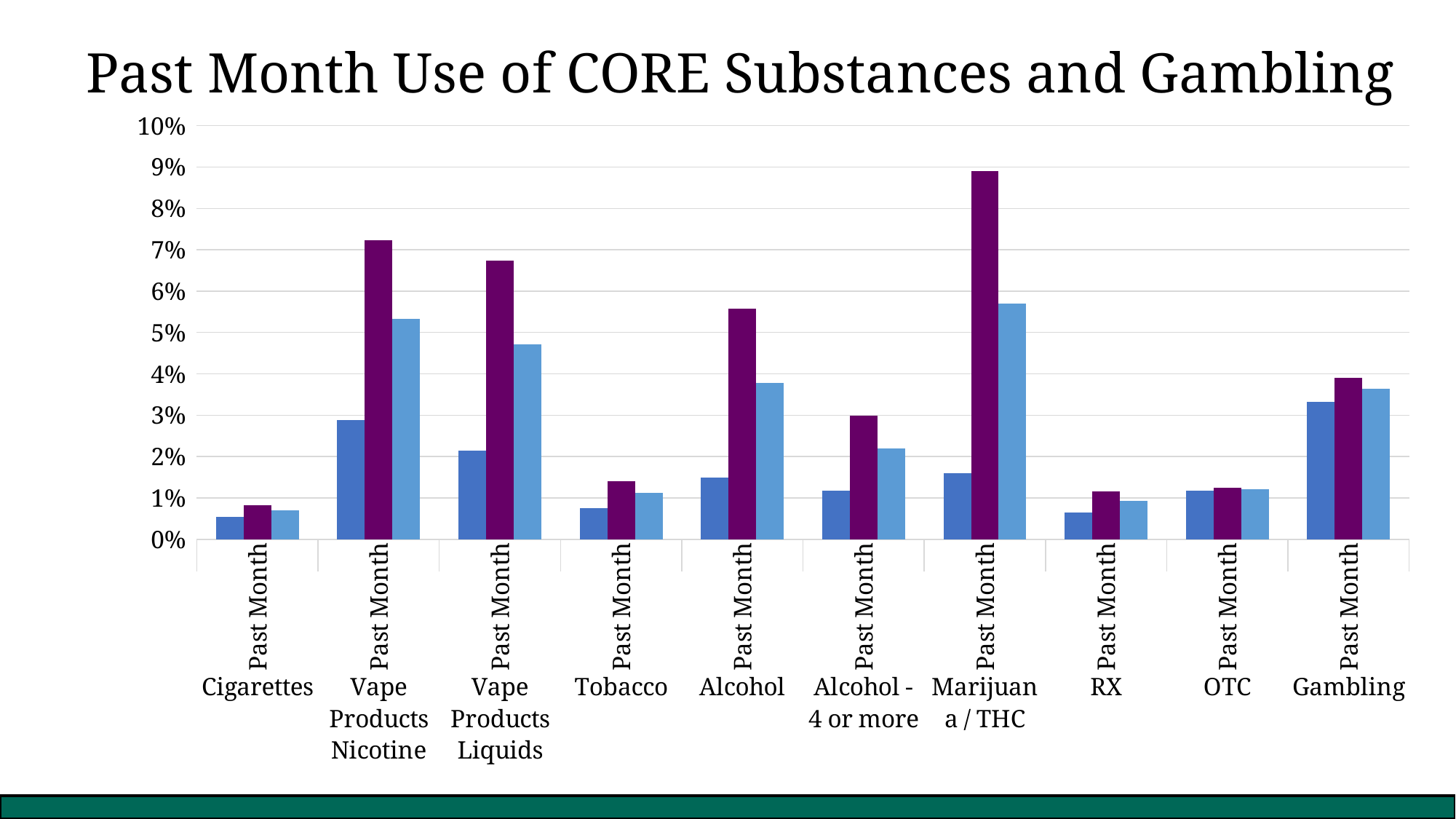
Is the purple bar for Alcohol greater or less than 5%? greater Which category has the shortest bars on the chart? Cigarettes How many substance/gambling categories are shown along the x axis? 10 What kind of chart is shown on the slide? bar chart Which category has the tallest bar on the chart? Marijuana / THC Is the dark blue bar for Cigarettes greater or less than 1%? less Is the purple bar for Marijuana / THC greater or less than 8%? greater What is the title of the chart? Past Month Use of CORE Substances and Gambling Which has a taller purple bar, Vape Products Nicotine or Vape Products Liquids? Vape Products Nicotine Which has a taller purple bar, Alcohol or Alcohol - 4 or more? Alcohol